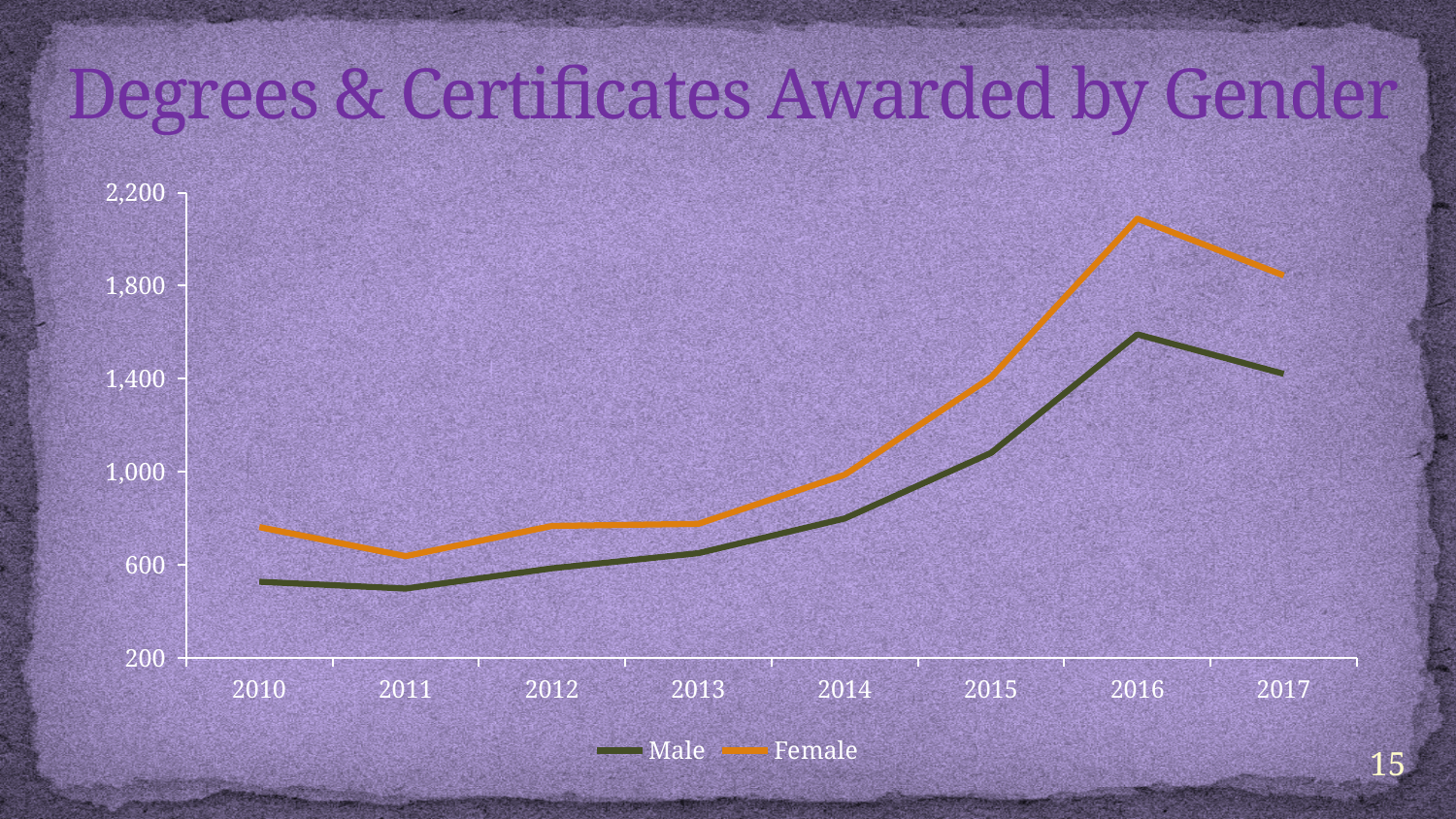
In which year is the Female line at its lowest? 2011 In which year does the Female line reach its highest value? 2016 How many series does the legend list? 2 Is the Female value for 2016 greater or less than 1,800? greater In which year does the Male line reach its highest value? 2016 How many years are shown on the x axis? 8 What kind of chart is shown on the slide? Line chart Is the Male value for 2011 greater or less than 600? less In 2016, which series has the larger value, Male or Female? Female Do the Male and Female values rise or fall from 2011 to 2016? Rise What is the title of the chart? Degrees & Certificates Awarded by Gender In which year is the Male line at its lowest? 2011